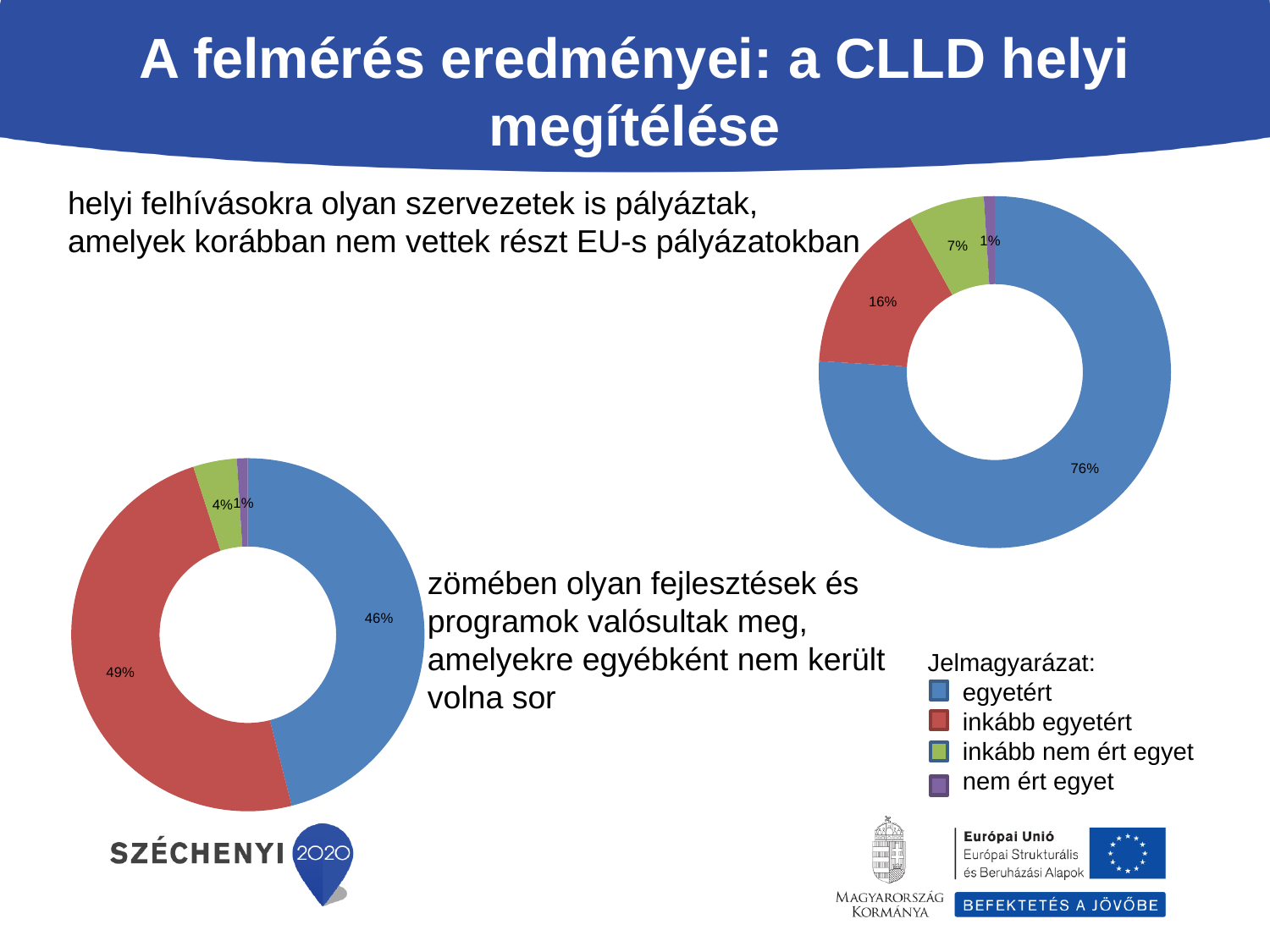
How many categories does the legend (Jelmagyarázat) list for the charts? 4 In the doughnut chart at the top right of the slide, what share is shown for the 'egyetért' (blue) slice? 76% In the doughnut chart at the top right of the slide, what share is shown for the 'inkább nem ért egyet' (green) slice? 7% In the doughnut chart at the top right of the slide, what is the difference between the 'egyetért' share and the 'inkább egyetért' share? 60 percentage points In the doughnut chart at the bottom left of the slide, what share is shown for the 'inkább egyetért' (red) slice? 49% In the doughnut chart at the bottom left of the slide, which is larger: the 'egyetért' share or the 'inkább egyetért' share? inkább egyetért What type of chart is used at the top right of the slide? Doughnut (pie) chart In the doughnut chart at the top right of the slide, what share is shown for the 'inkább egyetért' (red) slice? 16% In the doughnut chart at the top right of the slide, which category has the smallest share? nem ért egyet In the doughnut chart at the bottom left of the slide, what share is shown for the 'egyetért' (blue) slice? 46% In the doughnut chart at the bottom left of the slide, which category has the largest share? inkább egyetért Which colour represents 'nem ért egyet' in the legend? Purple